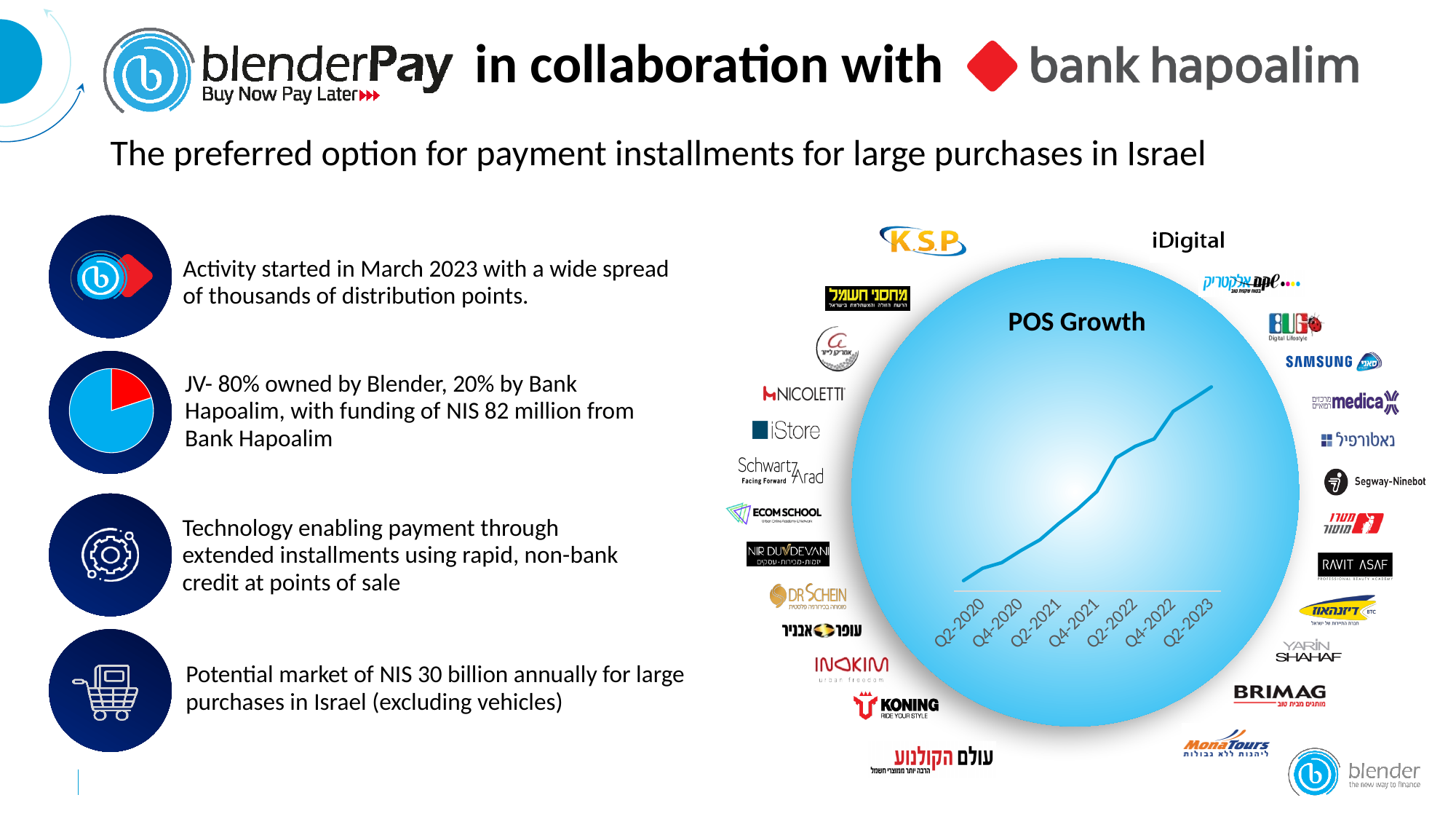
What is the last quarter label on the x axis of the POS Growth chart? Q2-2023 In the POS Growth chart, which is larger: the value for Q4-2020 or the value for Q4-2021? Q4-2021 How many quarter labels are shown on the x axis of the POS Growth chart? 7 Which quarter has the highest value in the POS Growth chart? Q2-2023 What is the title of the chart on the right of the slide? POS Growth Do the values in the POS Growth chart rise or fall from Q2-2020 to Q2-2023? rise What is the first quarter label on the x axis of the POS Growth chart? Q2-2020 How many lines are plotted in the POS Growth chart? 1 In the POS Growth chart, which is larger: the value for Q4-2022 or the value for Q2-2021? Q4-2022 What colour is the line in the POS Growth chart? blue What kind of chart is shown inside the blue circle on the right of the slide? line chart